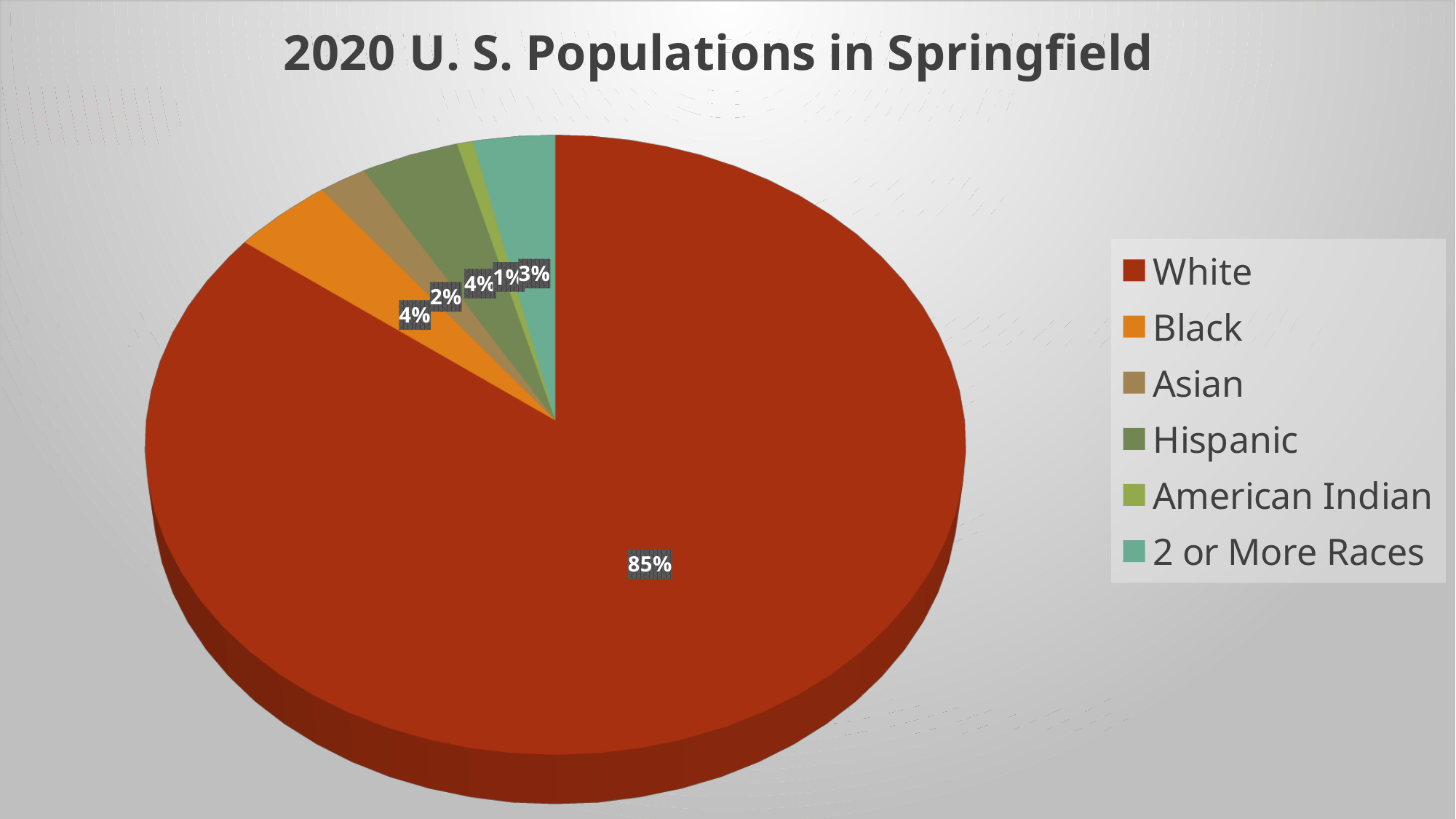
What percentage is shown for the American Indian slice? 1% Which category has the smallest slice of the pie? American Indian What percentage is shown for the Black slice? 4% What percentage is shown for the Asian slice? 2% What percentage of the pie does the White slice represent? 85% Which category has the largest slice of the pie? White What is the difference in percentage points between the White slice and the Black slice? 81 What type of chart is shown on the slide? pie chart What percentage is shown for the Hispanic slice? 4% What is the title of the chart? 2020 U. S. Populations in Springfield How many categories does the legend list? 6 What percentage is shown for the 2 or More Races slice? 3%